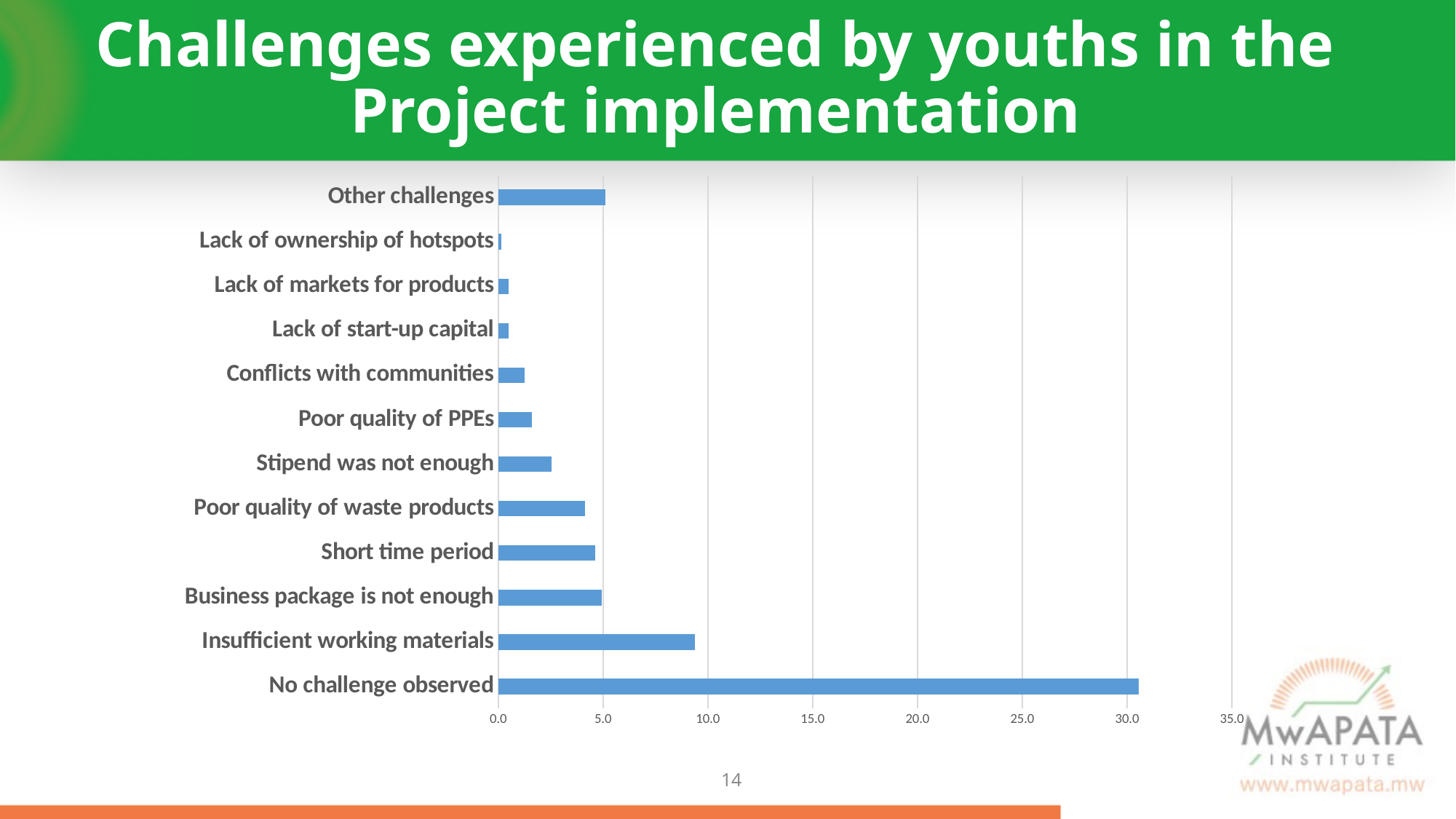
Is the value for No challenge observed greater or less than 25.0? greater What is the title of the slide containing the chart? Challenges experienced by youths in the Project implementation What kind of chart is shown on the slide? Bar chart Is the value for Insufficient working materials greater or less than 5.0? greater Is the value for Poor quality of waste products greater or less than 5.0? less Which is larger: the value for Insufficient working materials or the value for Business package is not enough? Insufficient working materials Which category has the highest value in the chart? No challenge observed How many challenge categories are plotted in the chart? 12 Which is larger: the value for Stipend was not enough or the value for Poor quality of PPEs? Stipend was not enough Which category has the lowest value in the chart? Lack of ownership of hotspots